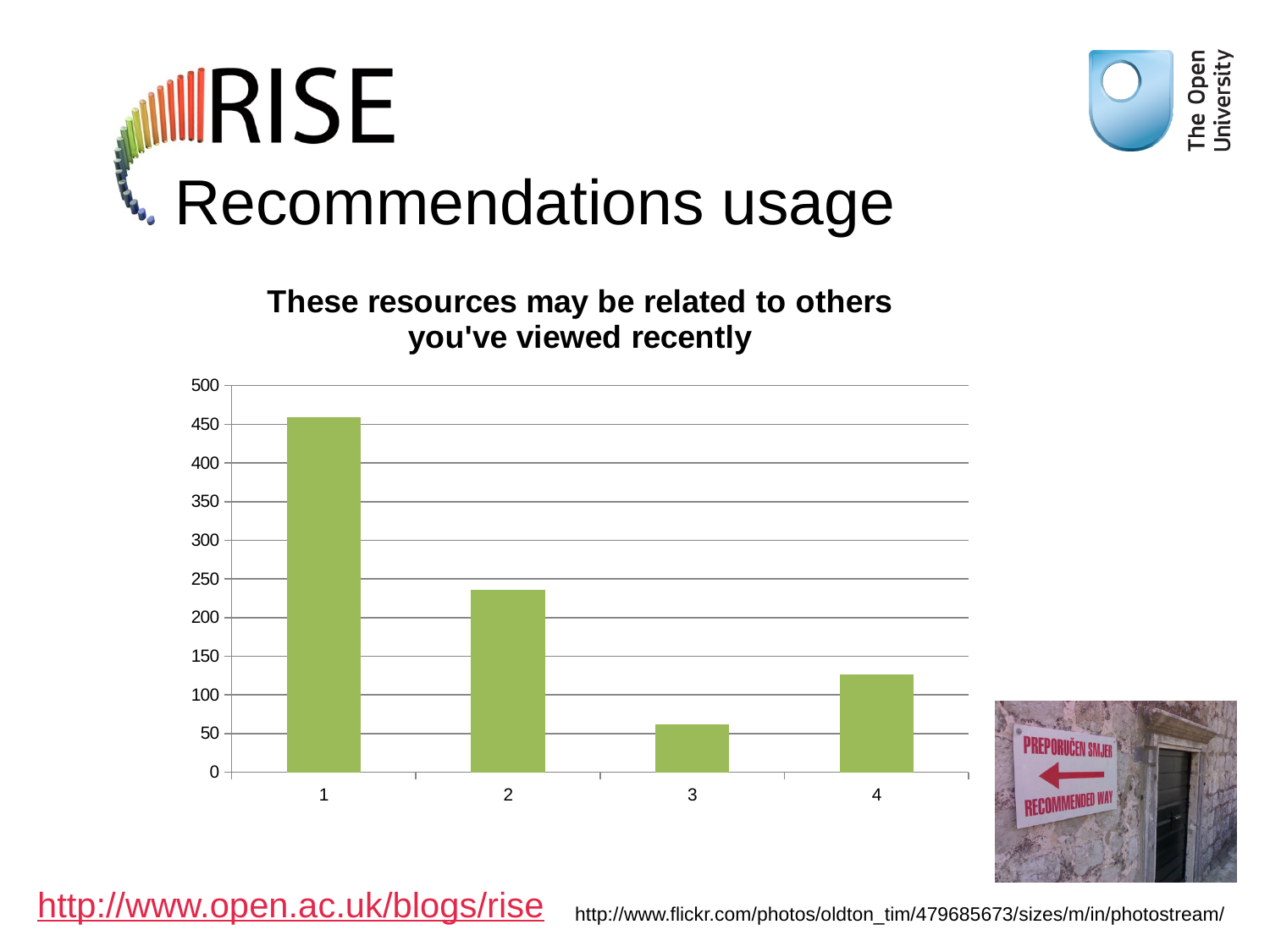
What kind of chart is shown on the slide? bar chart How many categories are shown on the x axis of the chart? 4 Is the value for category 3 greater or less than 100? less Is the value for category 1 greater or less than 400? greater Which has a larger value, category 3 or category 4? 4 Which has a larger value, category 2 or category 4? 2 What is the title of the chart? These resources may be related to others you've viewed recently What is the highest value shown on the y axis of the chart? 500 Which category has the lowest bar? 3 Is the value for category 4 greater or less than 100? greater Which category has the highest bar? 1